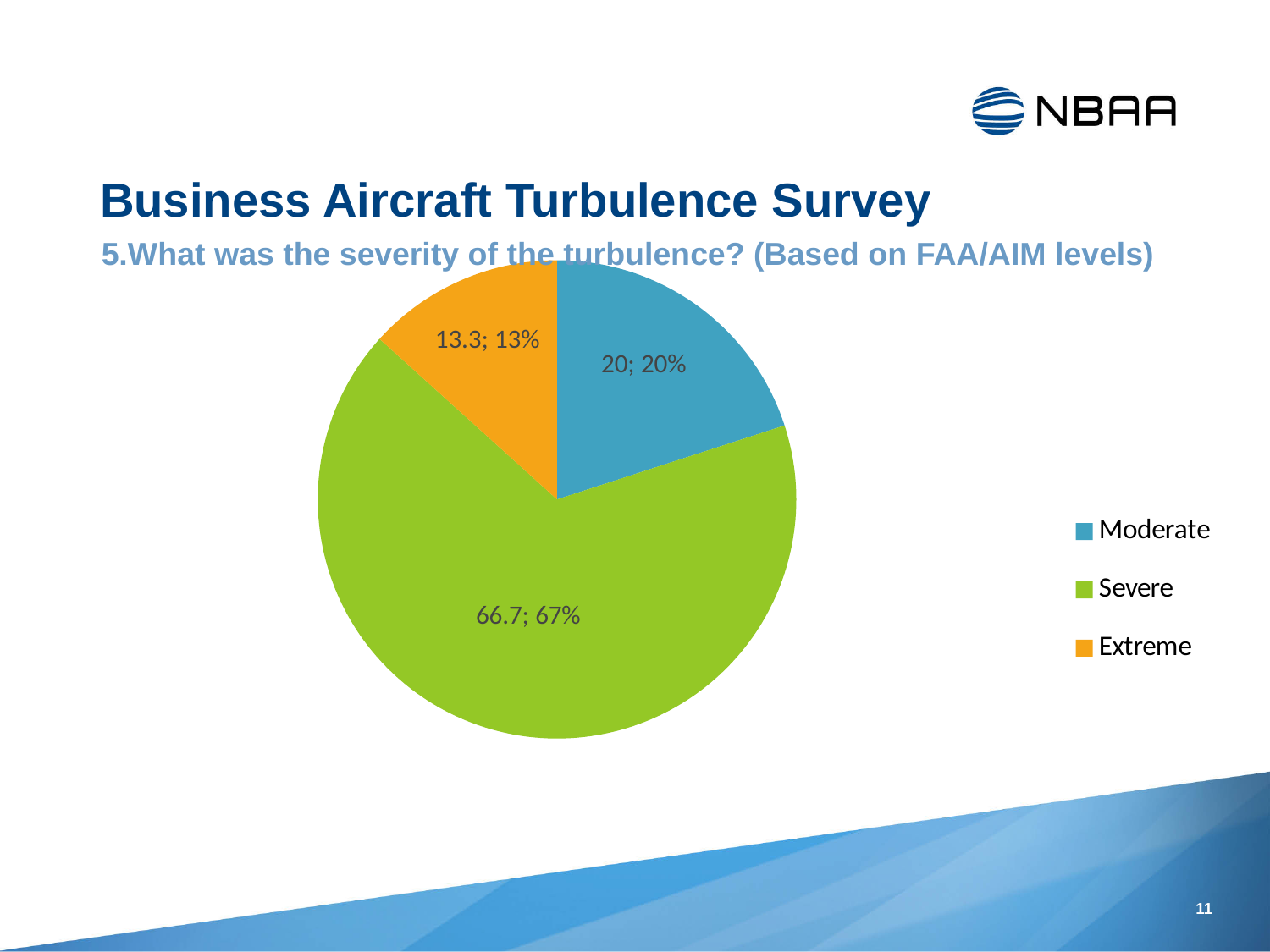
Which category has the smallest slice? Extreme What share of the pie does the Severe slice represent? 67% What kind of chart is shown on the slide? pie chart What value is shown for the Severe slice? 66.7 How many slices does the pie chart have? 3 Which is larger, the Moderate slice or the Extreme slice? Moderate Which category has the largest slice? Severe What value is shown for the Moderate slice? 20 What value is shown for the Extreme slice? 13.3 How many entries does the legend list? 3 What is the difference between the Severe value and the Moderate value? 46.7 What share of the pie does the Extreme slice represent? 13%